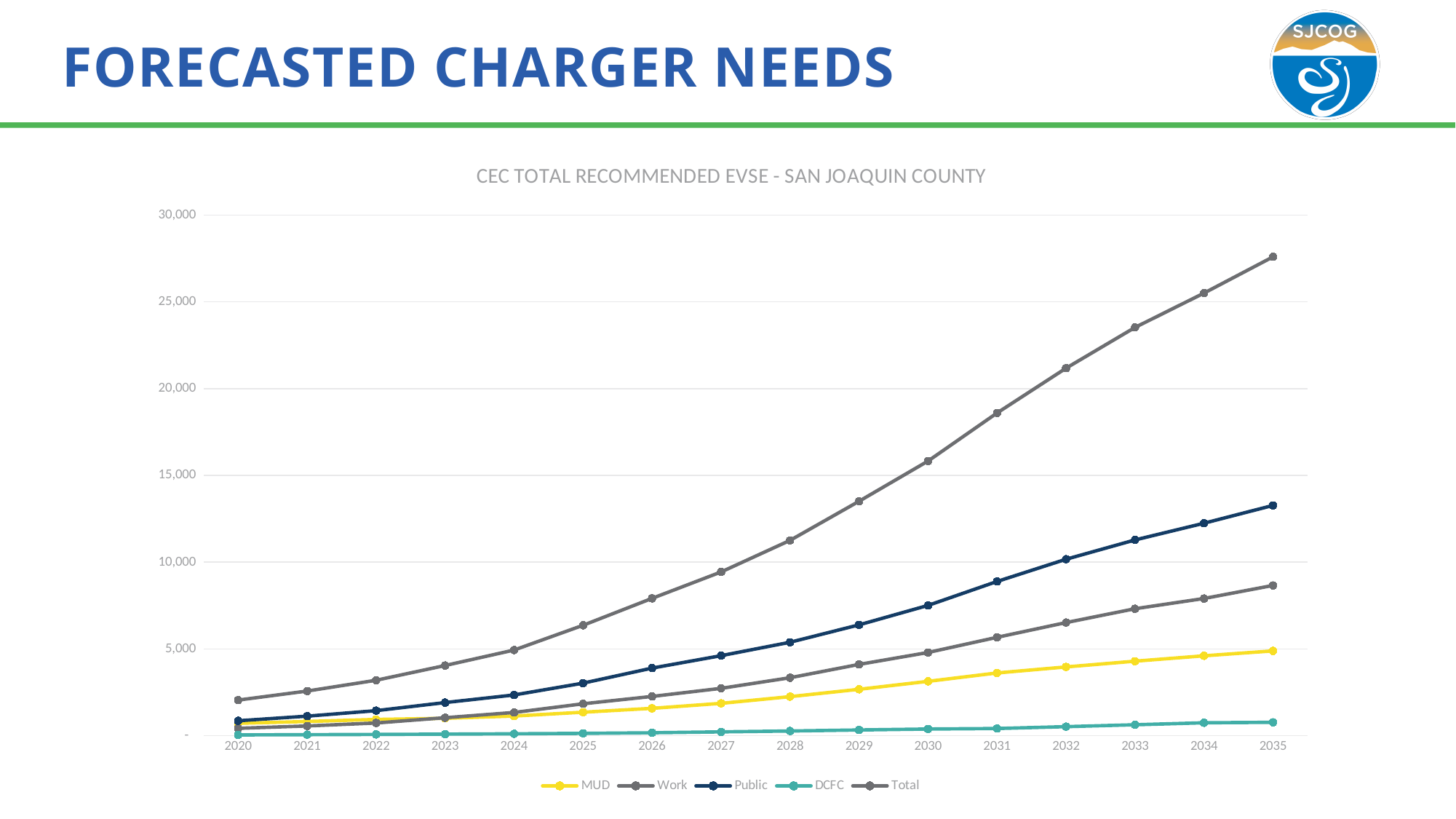
Which series has the highest value in 2035? Total Is the value for Total in 2030 greater or less than 15,000? greater How many years are plotted along the x axis? 16 Is the value for Public in 2035 greater or less than 10,000? greater Is the value for Work in 2035 greater or less than 10,000? less Does the Total series rise or fall from 2020 to 2035? rise What is the title of the chart? CEC TOTAL RECOMMENDED EVSE - SAN JOAQUIN COUNTY In 2035, which is larger: the value for Public or the value for Work? Public What kind of chart is shown on the slide? line chart Which series has the lowest value in 2035? DCFC How many series does the legend list? 5